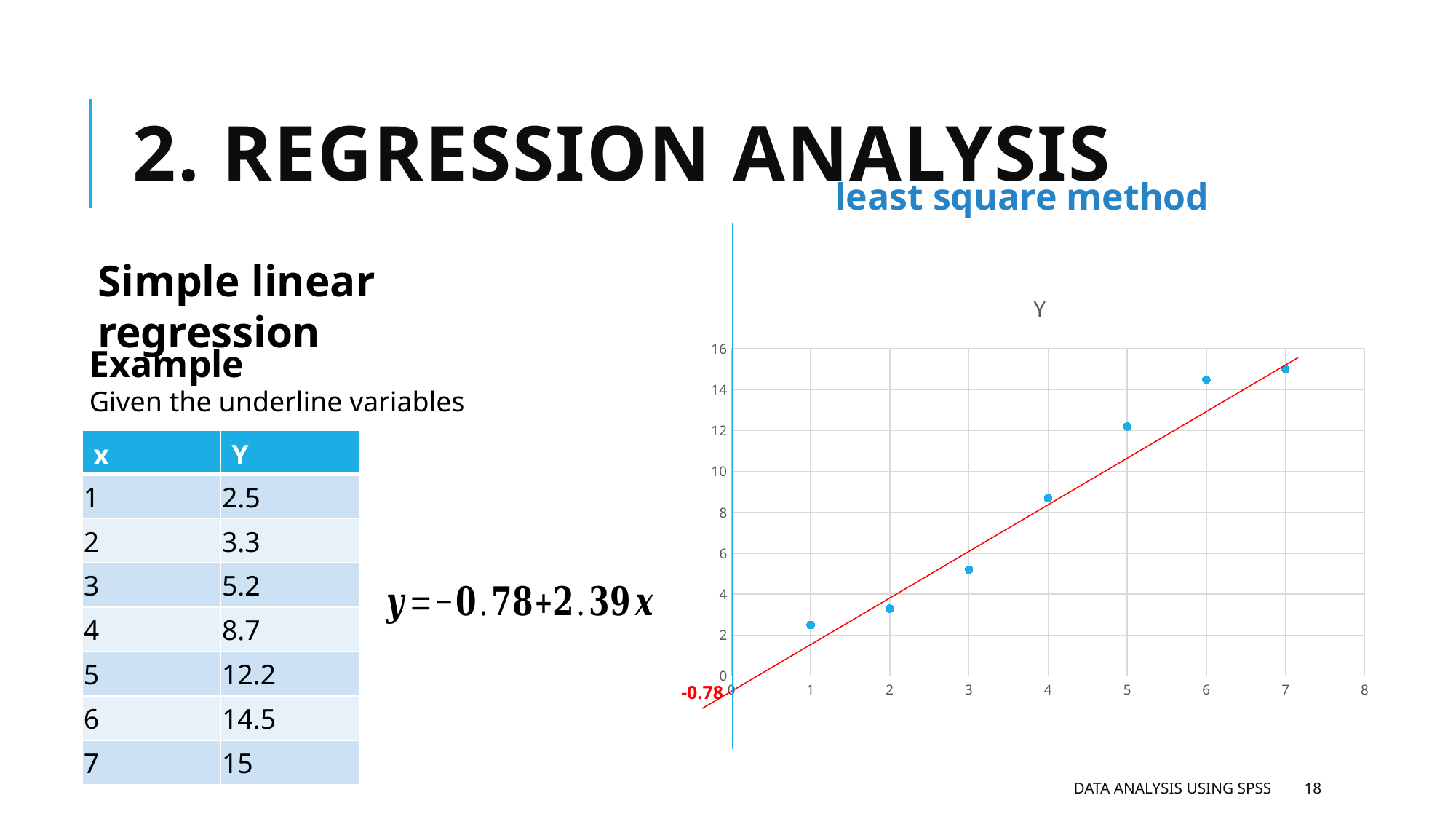
What is the title of the chart? Y How many data points are plotted in the chart? 7 What is the Y value plotted at x = 4? 8.7 What kind of chart is shown on the slide? scatter chart Which has the larger Y value, x = 5 or x = 3? x = 5 At which x value is the plotted Y value highest? 7 Is the Y value plotted at x = 5 greater or less than 10? greater Do the plotted Y values rise or fall as x increases along the x axis? rise What is the Y value plotted at x = 6? 14.5 Is the Y value plotted at x = 2 greater or less than 4? less At which x value is the plotted Y value lowest? 1 What is the difference between the Y value at x = 7 and the Y value at x = 1? 12.5